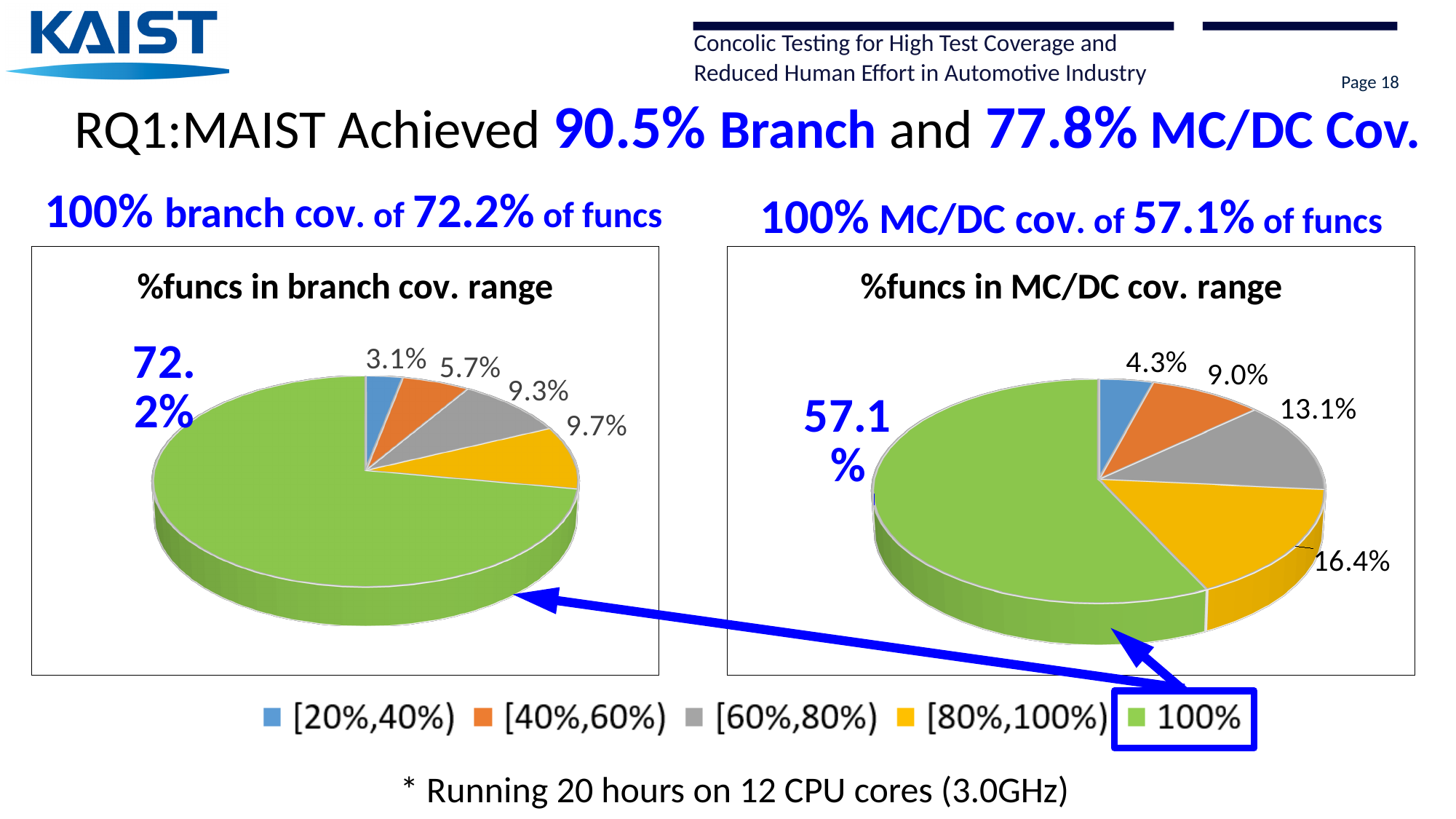
In the '%funcs in branch cov. range' chart, which category has the smallest slice? [20%,40%) In the '%funcs in MC/DC cov. range' chart, what share of functions falls in the [80%,100%) category? 16.4% What kind of chart is the '%funcs in branch cov. range' chart? Pie chart In the '%funcs in branch cov. range' chart, what share of functions falls in the 100% category? 72.2% In the '%funcs in MC/DC cov. range' chart, which category has the largest slice? 100% Which is larger: the [80%,100%) slice in the '%funcs in branch cov. range' chart or the [80%,100%) slice in the '%funcs in MC/DC cov. range' chart? %funcs in MC/DC cov. range Which legend entry is highlighted with a blue box on the slide? 100% How many categories does the legend list for the pie charts? 5 In the '%funcs in MC/DC cov. range' chart, what is the difference between the [60%,80%) and [40%,60%) slices? 4.1% In the '%funcs in branch cov. range' chart, what is the value for the [60%,80%) category? 9.3% What is the difference between the 100% slice in the '%funcs in branch cov. range' chart and the 100% slice in the '%funcs in MC/DC cov. range' chart? 15.1% In the '%funcs in MC/DC cov. range' chart, what is the value for the [20%,40%) category? 4.3%